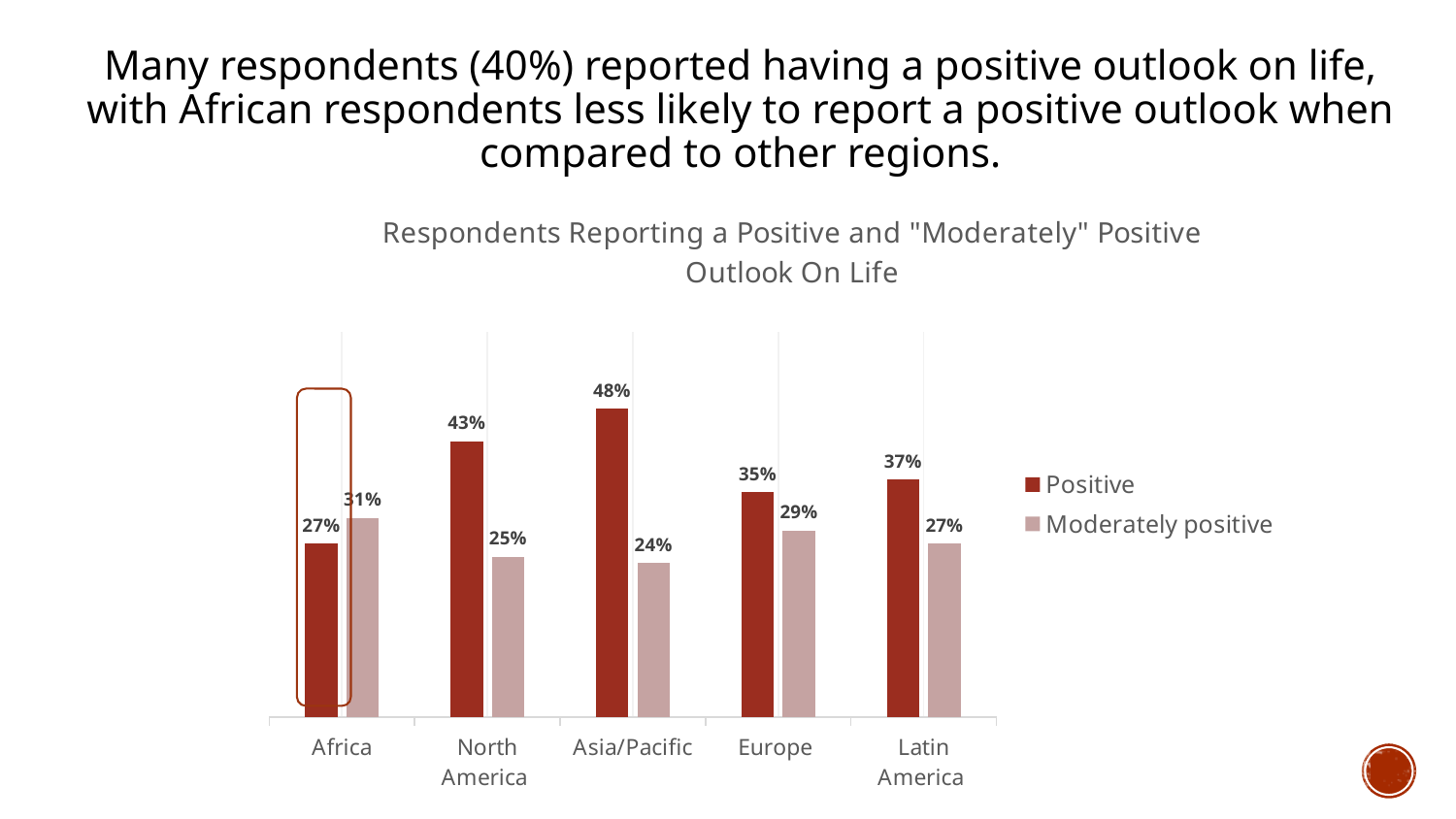
Which region has the lowest Moderately positive value? Asia/Pacific What is the Positive value for Asia/Pacific? 48% Which region has the highest Positive value? Asia/Pacific What percentage of Africa respondents reported a Positive outlook? 27% What kind of chart is shown on the slide? Bar chart How many series does the legend list? 2 What is the difference between the Positive and Moderately positive values for North America? 18% Which is larger for Africa, the Positive value or the Moderately positive value? Moderately positive Which region has the lowest Positive value? Africa What is the Moderately positive value for Europe? 29% What is the title of the chart? Respondents Reporting a Positive and "Moderately" Positive Outlook On Life How many regions are shown on the x axis? 5